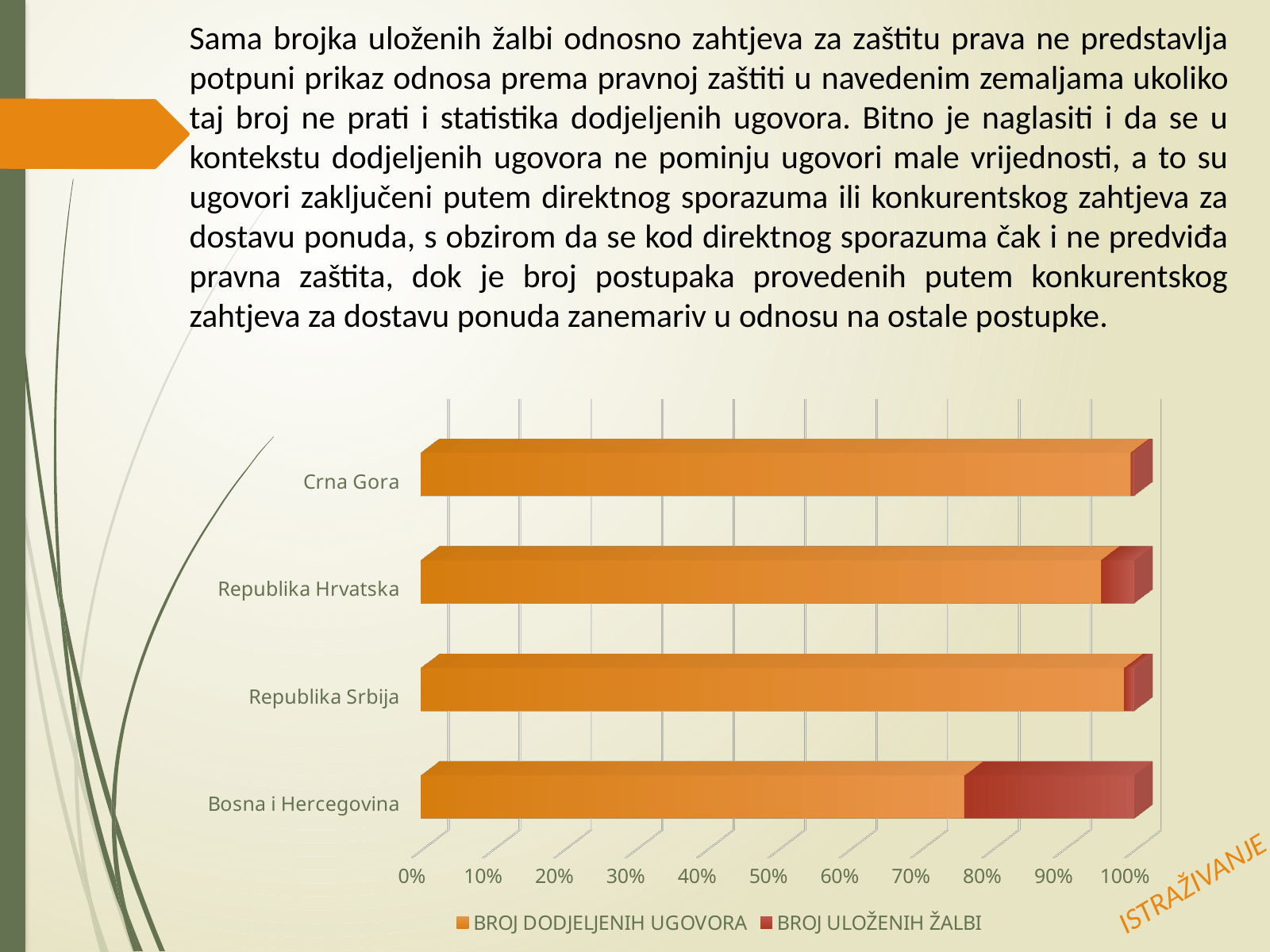
Which colour represents BROJ ULOŽENIH ŽALBI in the chart? red Which country has the largest share for BROJ ULOŽENIH ŽALBI? Bosna i Hercegovina How many countries are listed on the vertical axis of the chart? 4 Is the BROJ DODJELJENIH UGOVORA share for Crna Gora greater or less than 90%? greater Which country has the smallest share for BROJ ULOŽENIH ŽALBI? Crna Gora How many series does the chart legend list? 2 Which country has the largest share for BROJ DODJELJENIH UGOVORA? Crna Gora What are the two series named in the chart legend? BROJ DODJELJENIH UGOVORA and BROJ ULOŽENIH ŽALBI What kind of chart is shown on the slide? bar chart Which has the larger BROJ DODJELJENIH UGOVORA share, Republika Hrvatska or Bosna i Hercegovina? Republika Hrvatska Is the BROJ DODJELJENIH UGOVORA share for Bosna i Hercegovina greater or less than 90%? less Which has the larger BROJ ULOŽENIH ŽALBI share, Bosna i Hercegovina or Republika Srbija? Bosna i Hercegovina